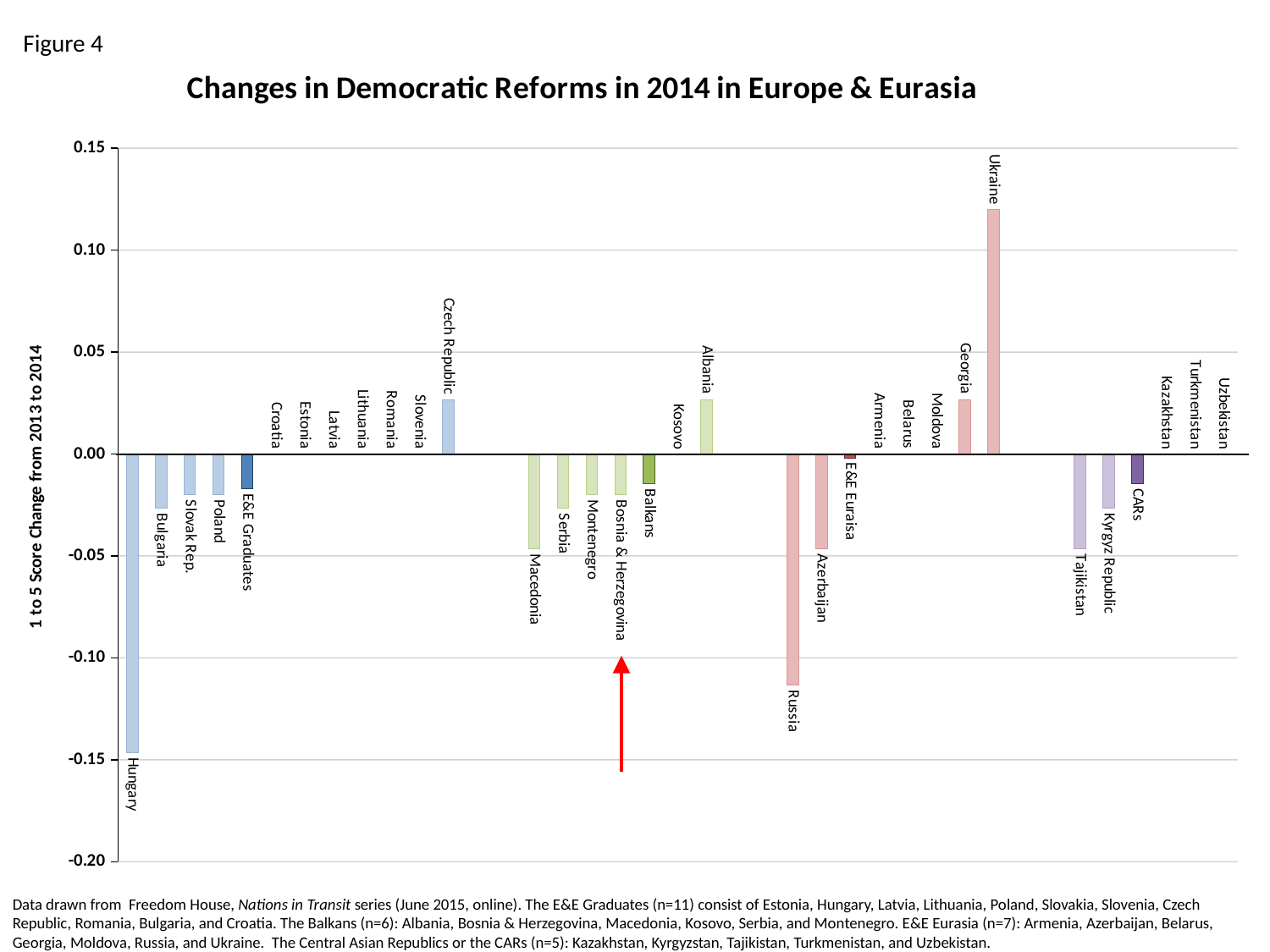
How many bars in the chart show a positive score change? 4 Which country's bar does the red arrow point to? Bosnia & Herzegovina What type of chart is shown on the slide? bar chart Is the value for Czech Republic greater or less than 0.05? less What is the title of the chart? Changes in Democratic Reforms in 2014 in Europe & Eurasia Which country shows the largest negative score change in the chart? Hungary Is the value for Hungary greater or less than -0.10? less Which country shows the largest positive score change in the chart? Ukraine Is the value for Ukraine greater or less than 0.10? greater Which shows a larger decline, Hungary or Russia? Hungary Which has the larger value, Ukraine or Georgia? Ukraine